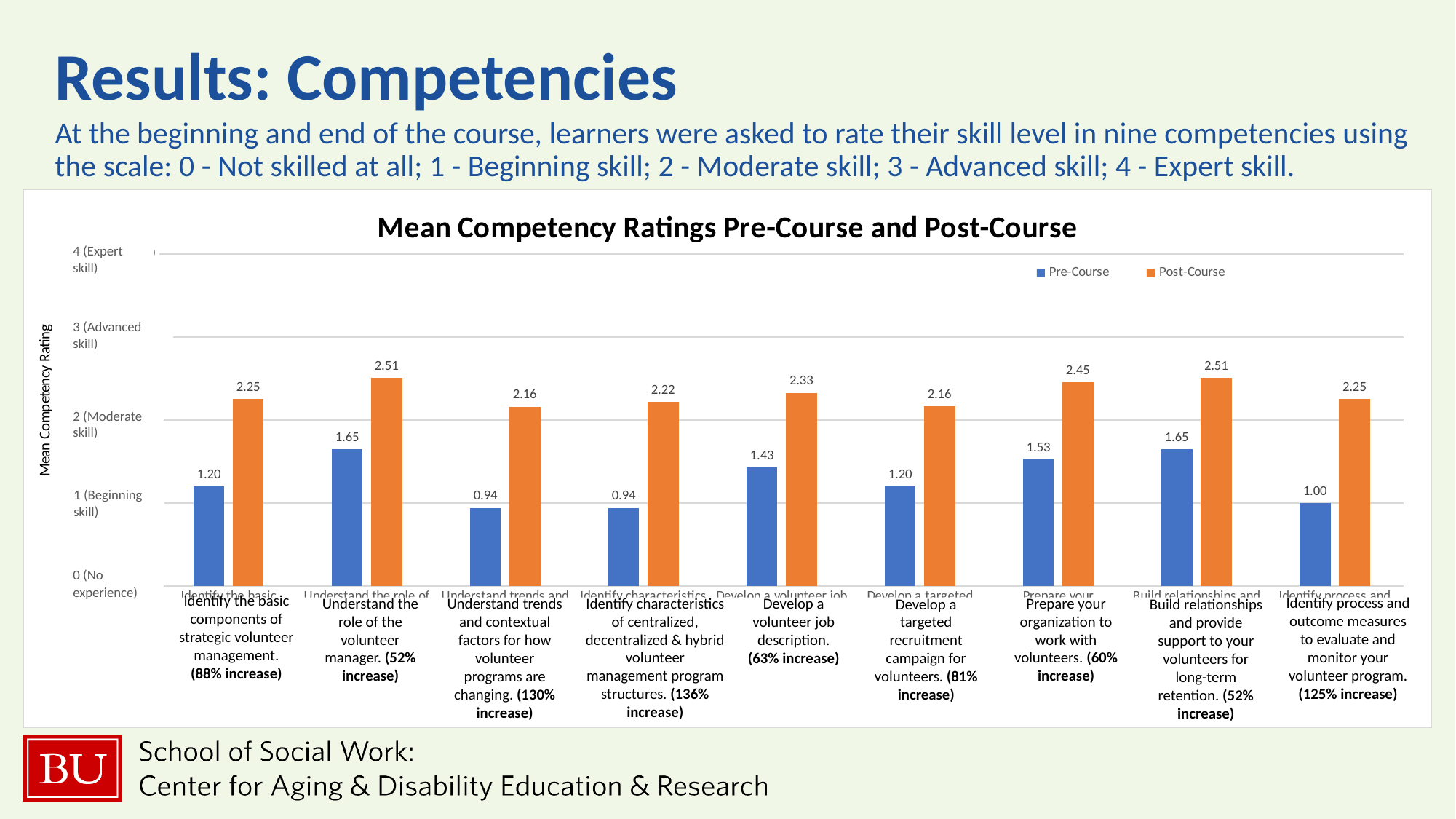
What is the highest Post-Course mean rating shown in the chart? 2.51 What is the title of the chart? Mean Competency Ratings Pre-Course and Post-Course What is the Pre-Course mean rating for 'Develop a volunteer job description'? 1.43 What is the Post-Course mean rating for 'Understand trends and contextual factors for how volunteer programs are changing'? 2.16 What is the Post-Course mean rating for 'Prepare your organization to work with volunteers'? 2.45 What type of chart is shown on the slide? Bar chart Which colour represents the Post-Course series in the chart? Orange What is the difference between the Post-Course and Pre-Course mean ratings for 'Develop a volunteer job description'? 0.90 Which is larger for 'Develop a targeted recruitment campaign for volunteers': the Pre-Course or the Post-Course mean rating? Post-Course How many competencies (categories) are plotted in the chart? 9 What is the Pre-Course mean rating for 'Identify process and outcome measures to evaluate and monitor your volunteer program'? 1.00 How many series does the chart legend list? 2